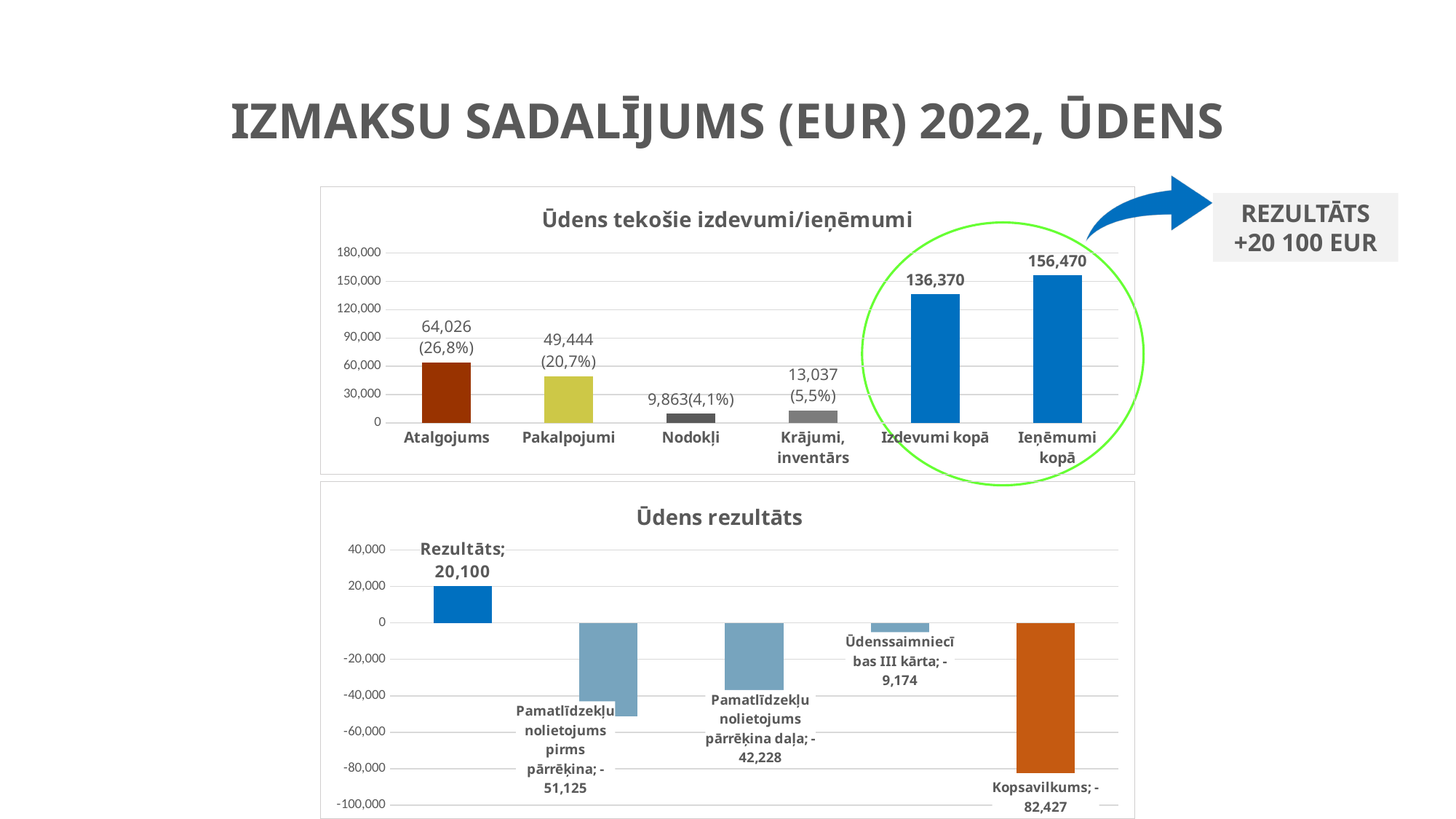
In the chart titled "Ūdens tekošie izdevumi/ieņēmumi", which is larger: Pakalpojumi or Krājumi, inventārs? Pakalpojumi In the chart titled "Ūdens rezultāts", what is the value for Kopsavilkums? -82,427 In the chart titled "Ūdens tekošie izdevumi/ieņēmumi", what is the difference between Ieņēmumi kopā and Izdevumi kopā? 20,100 In the chart titled "Ūdens rezultāts", what is the value for Rezultāts? 20,100 In the chart titled "Ūdens tekošie izdevumi/ieņēmumi", what percentage is shown for Pakalpojumi? 20,7% How many categories are shown in the chart titled "Ūdens tekošie izdevumi/ieņēmumi"? 6 In the chart titled "Ūdens tekošie izdevumi/ieņēmumi", what is the value for Atalgojums? 64,026 In the chart titled "Ūdens tekošie izdevumi/ieņēmumi", what is the value for Ieņēmumi kopā? 156,470 In the chart titled "Ūdens rezultāts", what is the value for Ūdenssaimniecības III kārta? -9,174 What type of chart is the chart titled "Ūdens rezultāts"? Bar chart In the chart titled "Ūdens tekošie izdevumi/ieņēmumi", which category has the lowest value? Nodokļi In the chart titled "Ūdens rezultāts", which category has the lowest value? Kopsavilkums